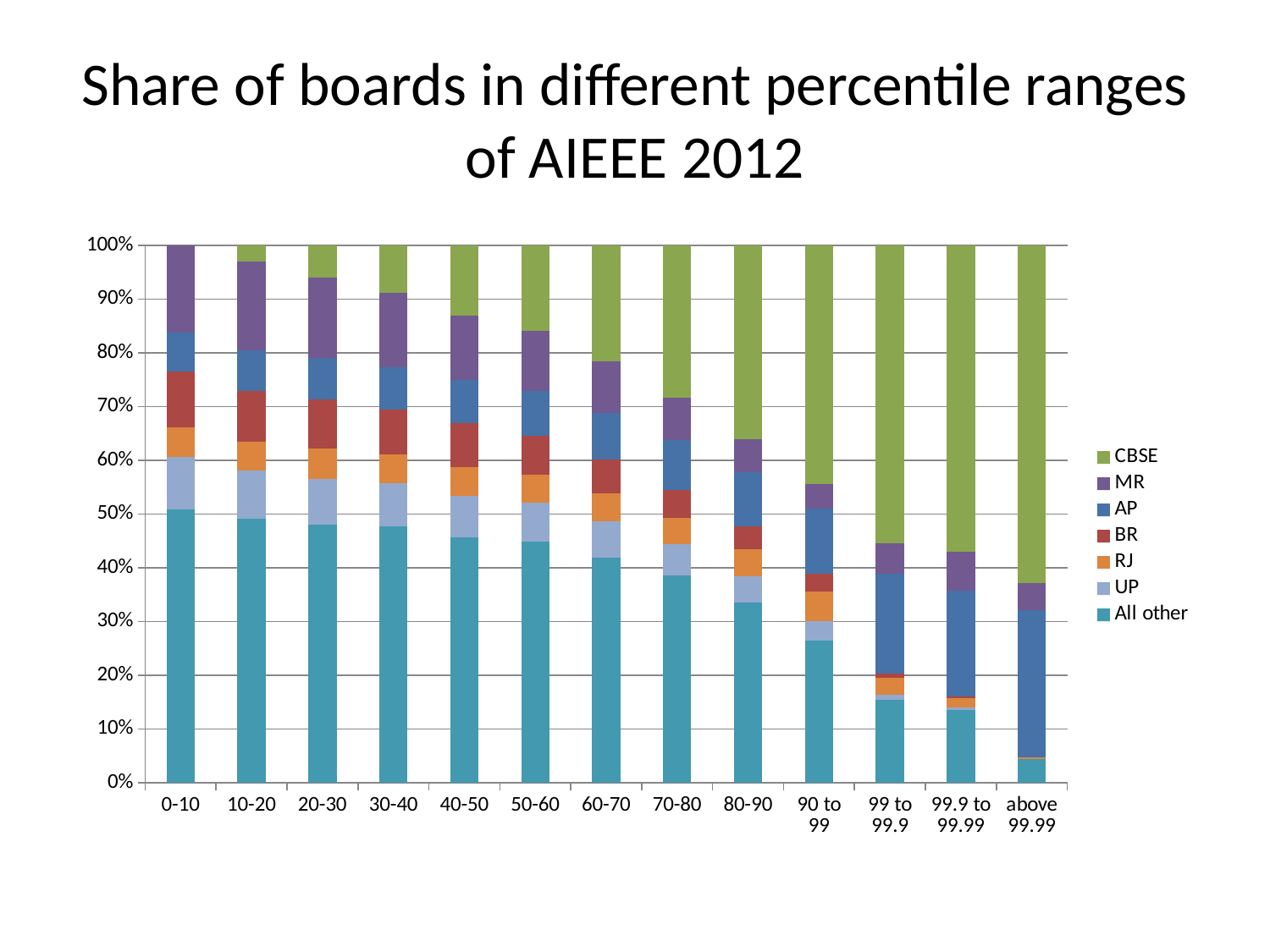
Which percentile range has the largest 'All other' share? 0-10 Does the share of 'All other' rise or fall as you move from the 0-10 range to the above 99.99 range? fall Is the 'All other' share in the above 99.99 range greater or less than 10%? less Is the 'All other' share in the 90 to 99 range greater or less than 20%? greater How many series does the legend list? 7 What kind of chart is shown on the slide? stacked bar chart How many percentile range categories are shown on the x axis? 13 Is the 'All other' share in the 40-50 range greater or less than 50%? less Which percentile range has the smallest 'All other' share? above 99.99 What is the title of the chart? Share of boards in different percentile ranges of AIEEE 2012 Does the share of CBSE rise or fall as you move from the 0-10 range to the above 99.99 range? rise Which series is listed first (at the top) in the legend? CBSE